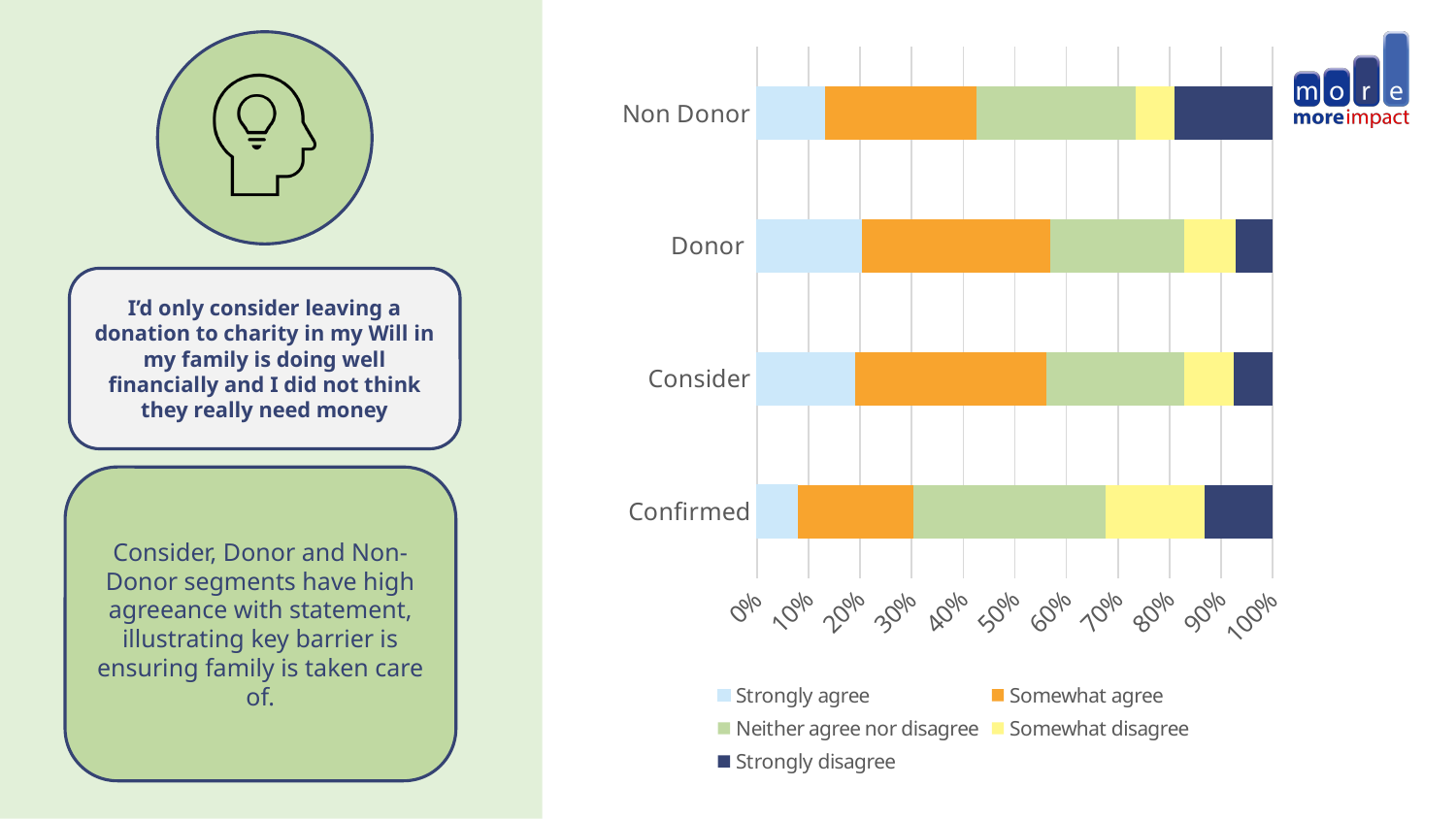
Is the 'Neither agree nor disagree' value for Confirmed greater or less than 30%? greater Which is larger: the 'Strongly disagree' segment for Non Donor or for Confirmed? Non Donor What kind of chart is shown on the slide? Stacked bar chart Which category has the largest 'Neither agree nor disagree' segment? Confirmed Which category has the smallest 'Strongly agree' segment? Confirmed What colour represents 'Somewhat agree' in the legend? Orange Is the 'Strongly agree' value for Donor greater or less than 10%? greater How many categories are plotted on the chart's vertical axis? 4 Which category has the largest 'Somewhat disagree' segment? Confirmed Is the 'Strongly agree' value for Confirmed greater or less than 10%? less Which category has the largest 'Strongly disagree' segment? Non Donor How many series does the chart's legend list? 5